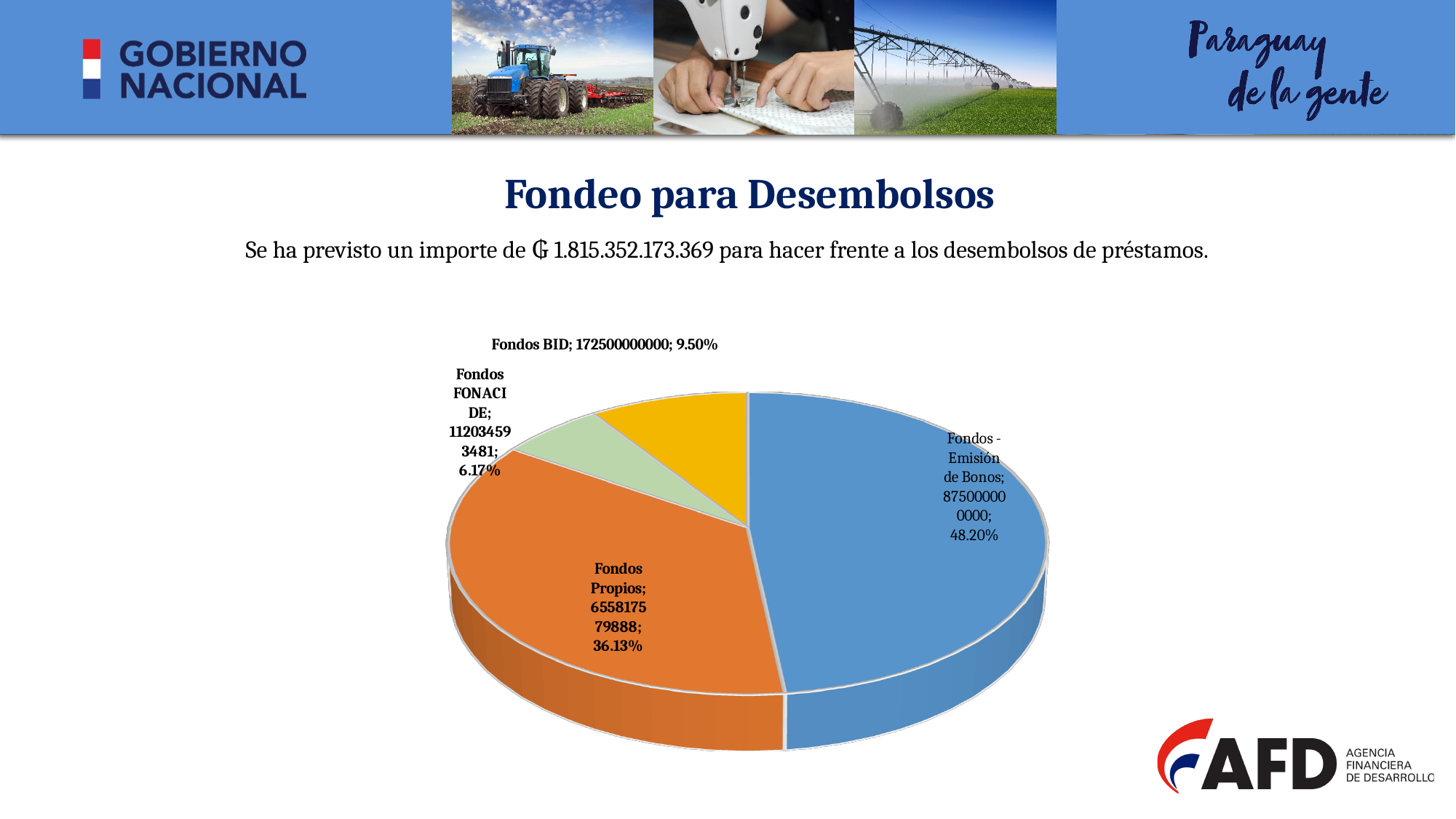
What percentage share does Fondos - Emisión de Bonos have in the pie chart? 48.20% How many slices does the pie chart have? 4 What percentage share does Fondos FONACIDE have in the pie chart? 6.17% What percentage share does Fondos BID have in the pie chart? 9.50% Which is larger, the share of Fondos BID or the share of Fondos FONACIDE? Fondos BID What is the value shown for Fondos - Emisión de Bonos? 875000000000 Which slice of the pie chart is the largest? Fondos - Emisión de Bonos What is the difference in percentage points between the share of Fondos - Emisión de Bonos and the share of Fondos Propios? 12.07% What is the value shown for Fondos BID? 172500000000 Which slice of the pie chart is the smallest? Fondos FONACIDE What kind of chart is shown on the slide? pie chart